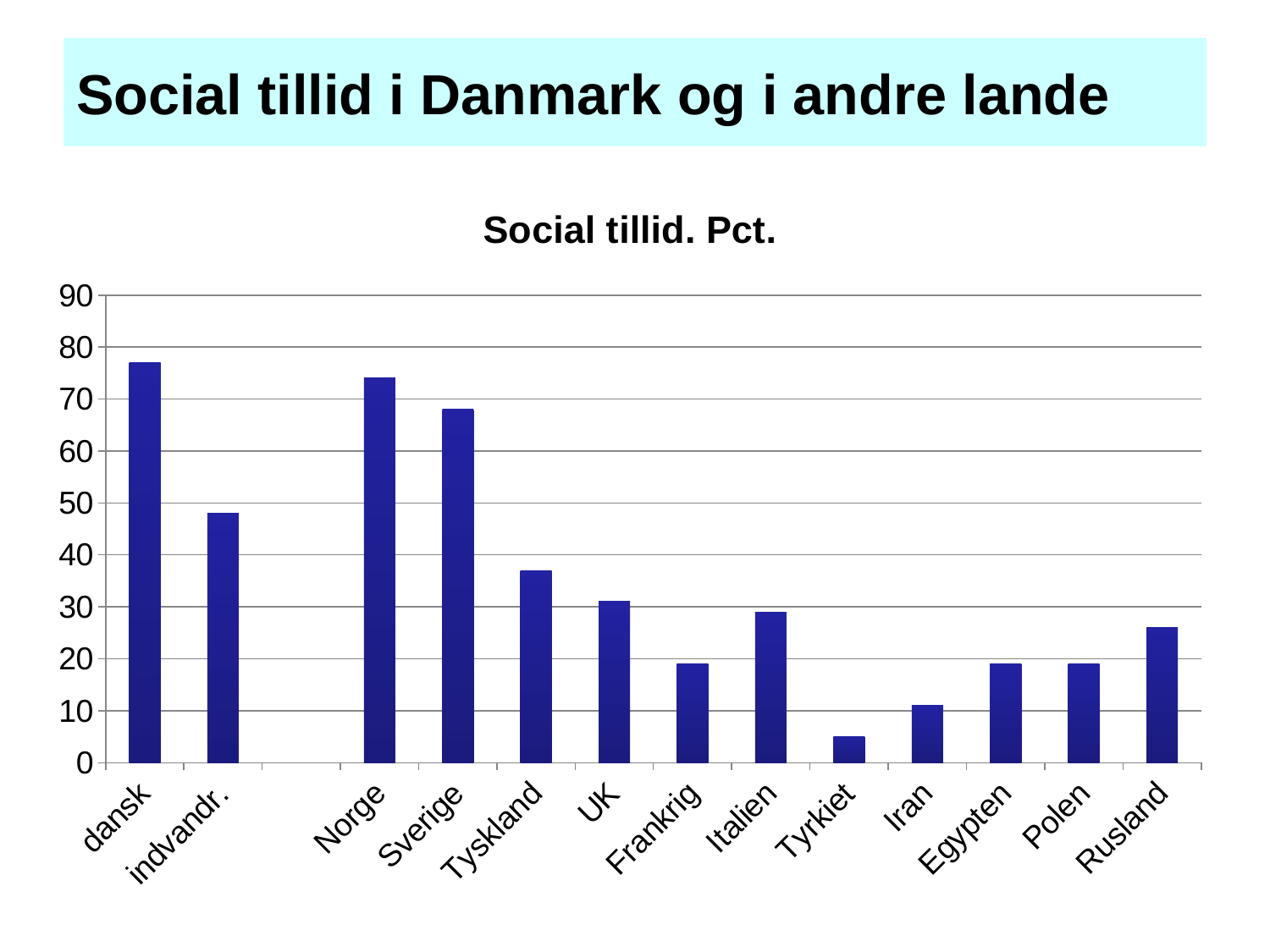
Is the value for indvandr. greater or less than 50? less Is the value for Tyskland greater or less than 40? less What is the title of the chart? Social tillid. Pct. Which category has the highest value in the chart? dansk How many bars are plotted in the chart? 13 What type of chart is shown on the slide? bar chart Which has a larger value, Frankrig or Rusland? Rusland Is the value for Rusland greater or less than 20? greater Which has a larger value, Sverige or Tyskland? Sverige Which category has the lowest value in the chart? Tyrkiet